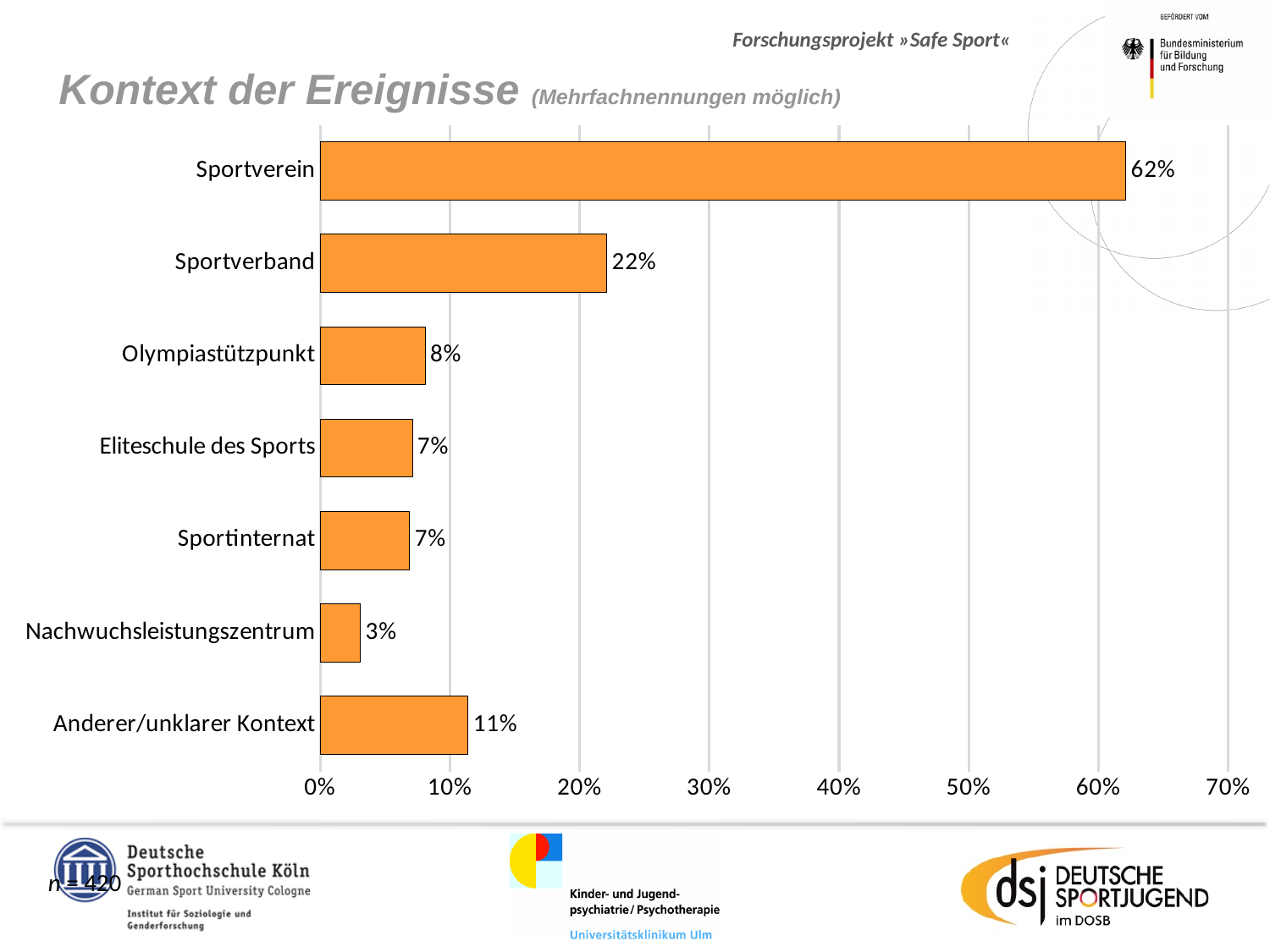
What kind of chart is shown on the slide? bar chart Is the value for Sportverband greater or less than 30%? less Which category has the highest value? Sportverein Which is larger, the value for Olympiastützpunkt or the value for Anderer/unklarer Kontext? Anderer/unklarer Kontext What is the difference between the values for Sportverein and Sportverband? 40% What is the value for Nachwuchsleistungszentrum? 3% How many categories are shown in the chart? 7 What is the value for Anderer/unklarer Kontext? 11% What is the value for Sportverband? 22% Which category has the lowest value? Nachwuchsleistungszentrum What is the title of the chart? Kontext der Ereignisse What is the value for Sportverein? 62%